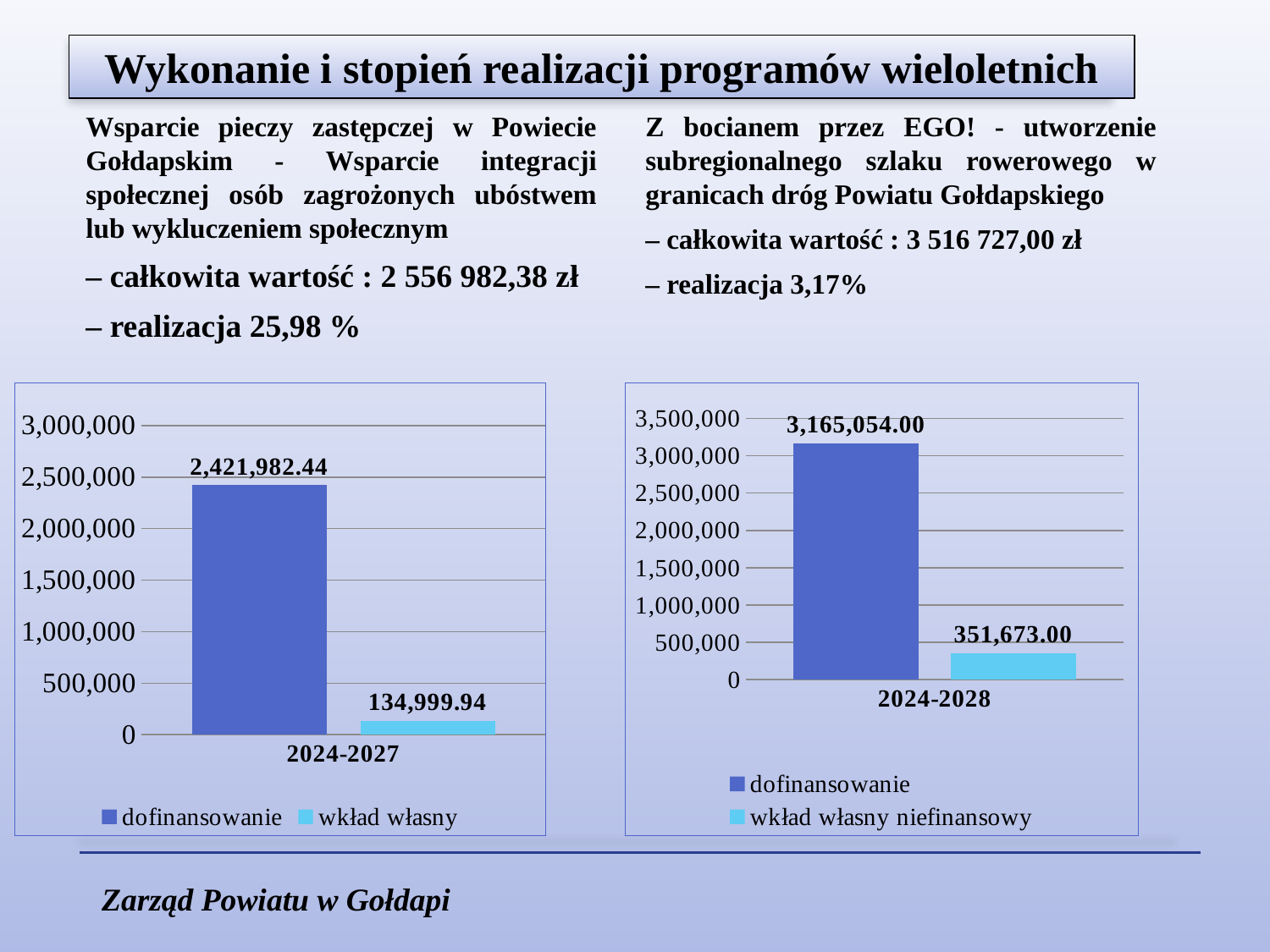
In the right chart, which series has the lower value? wkład własny niefinansowy In the left chart, which series has the higher value? dofinansowanie In the left chart, what is the value of dofinansowanie for 2024-2027? 2,421,982.44 Is the dofinansowanie bar in the right chart larger than the dofinansowanie bar in the left chart? Yes In the left chart, what is the value of wkład własny for 2024-2027? 134,999.94 In the right chart, is the value for wkład własny niefinansowy greater or less than 500,000? less In the right chart, what is the value of dofinansowanie for 2024-2028? 3,165,054.00 In the left chart, what is the difference between dofinansowanie and wkład własny? 2,286,982.50 In the right chart, what is the difference between dofinansowanie and wkład własny niefinansowy? 2,813,381.00 How many series does the legend of the right chart list? 2 In the right chart, what is the value of wkład własny niefinansowy for 2024-2028? 351,673.00 What type of chart is the left chart? Bar chart